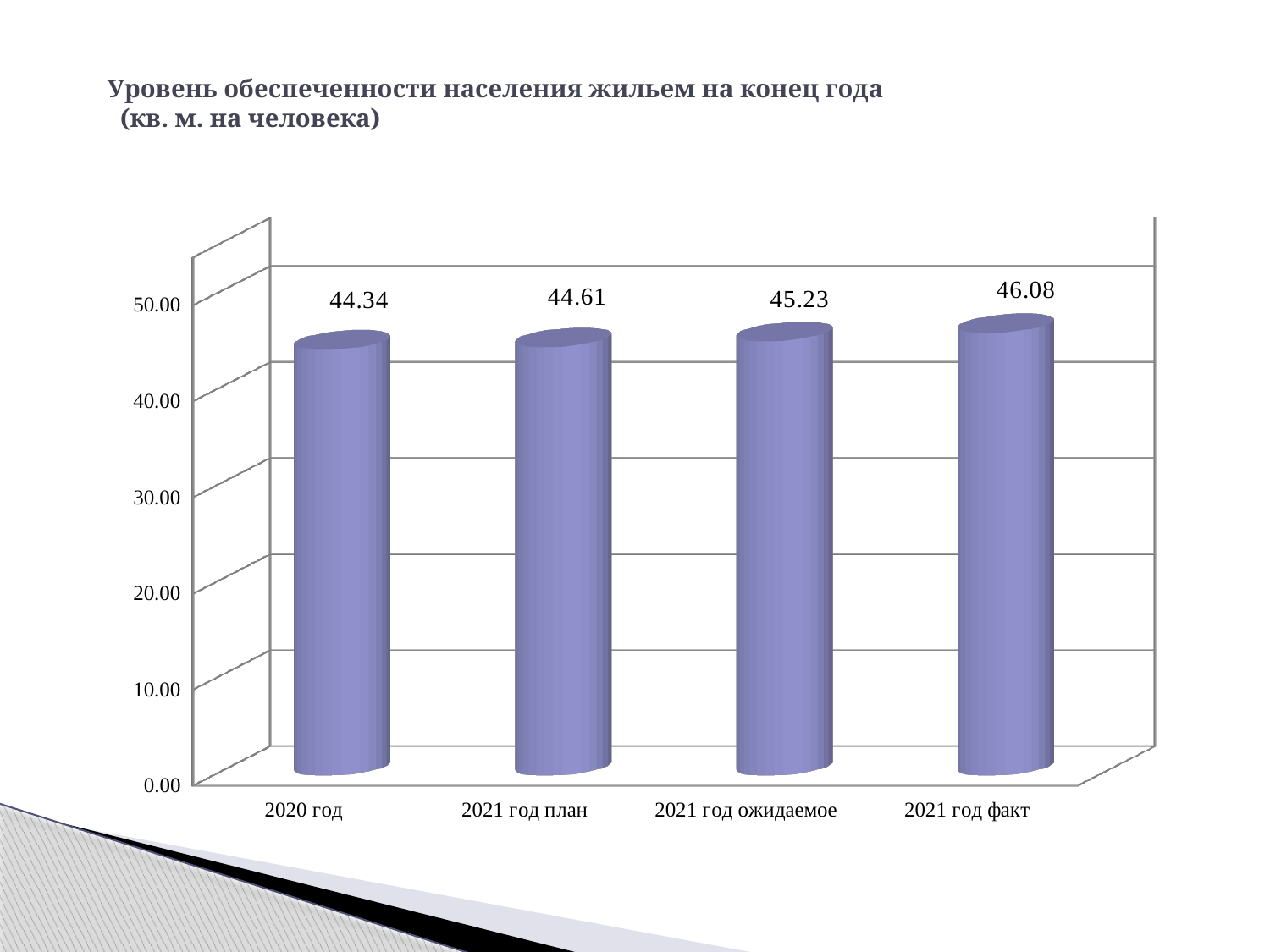
What is the value for 2021 год ожидаемое? 45.23 Which category has the highest value? 2021 год факт Which category has the lowest value? 2020 год What is the value for 2021 год факт? 46.08 What is the value for 2021 год план? 44.61 What is the difference between the values for 2021 год факт and 2020 год? 1.74 What is the value for 2020 год? 44.34 How many categories are shown on the x axis? 4 What is the difference between the values for 2021 год факт and 2021 год план? 1.47 What kind of chart is shown on the slide? bar chart Which is larger, the value for 2021 год ожидаемое or the value for 2021 год план? 2021 год ожидаемое Do the values rise or fall from left to right along the x axis? rise